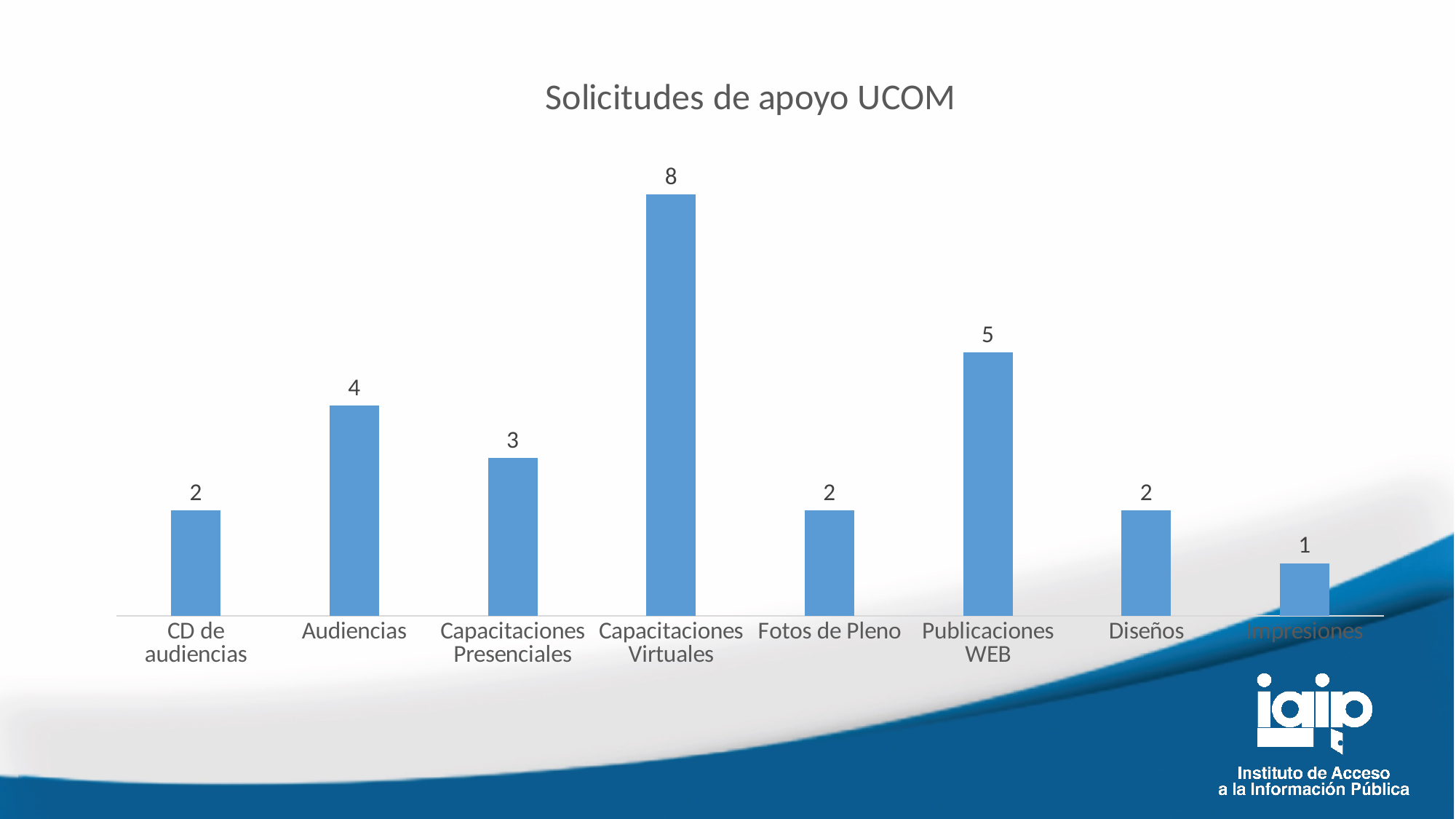
What is the difference between Capacitaciones Virtuales and Publicaciones WEB? 3 Which category has the highest value? Capacitaciones Virtuales What kind of chart is this? Bar chart What is the difference between Audiencias and Diseños? 2 What is the title of the chart? Solicitudes de apoyo UCOM What is the value for Capacitaciones Virtuales? 8 Which is larger, Audiencias or Capacitaciones Presenciales? Audiencias Which category has the lowest value? Impresiones How many categories are shown on the x axis? 8 What is the value for Impresiones? 1 What is the value for Publicaciones WEB? 5 What is the value for Audiencias? 4